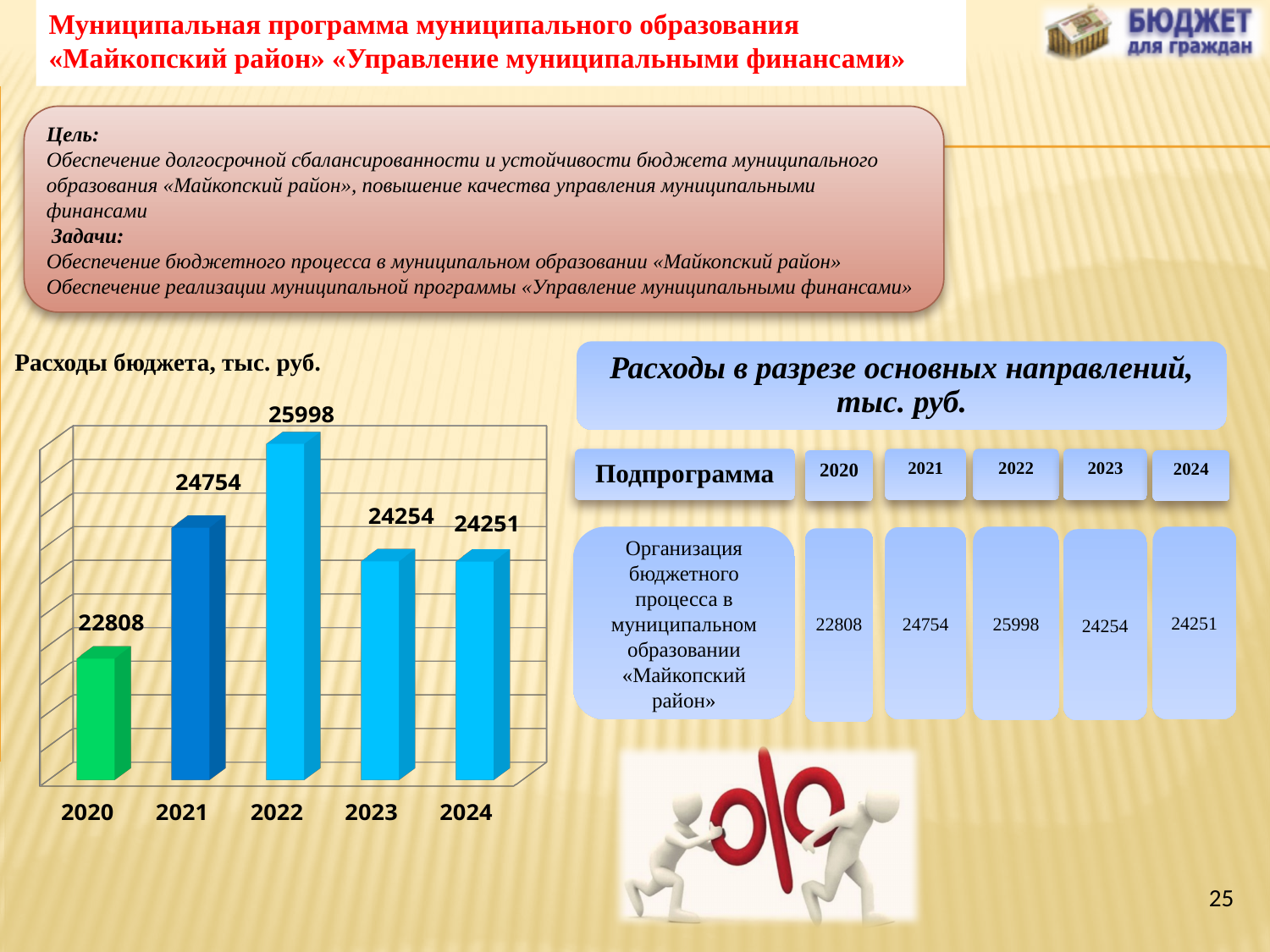
What is the value for 2020 in the chart 'Расходы бюджета, тыс. руб.'? 22808 In the chart 'Расходы бюджета, тыс. руб.', which is larger: the value for 2021 or the value for 2020? 2021 What is the difference between the values for 2021 and 2023 in the chart 'Расходы бюджета, тыс. руб.'? 500 In the chart 'Расходы бюджета, тыс. руб.', do the values rise or fall from 2020 to 2022? rise What is the value for 2022 in the chart 'Расходы бюджета, тыс. руб.'? 25998 Which year has the highest value in the chart 'Расходы бюджета, тыс. руб.'? 2022 What is the difference between the values for 2022 and 2020 in the chart 'Расходы бюджета, тыс. руб.'? 3190 What kind of chart is 'Расходы бюджета, тыс. руб.'? bar chart What is the title of the bar chart on the left of the slide? Расходы бюджета, тыс. руб. How many years are shown in the chart 'Расходы бюджета, тыс. руб.'? 5 Which year has the lowest value in the chart 'Расходы бюджета, тыс. руб.'? 2020 What is the value for 2024 in the chart 'Расходы бюджета, тыс. руб.'? 24251